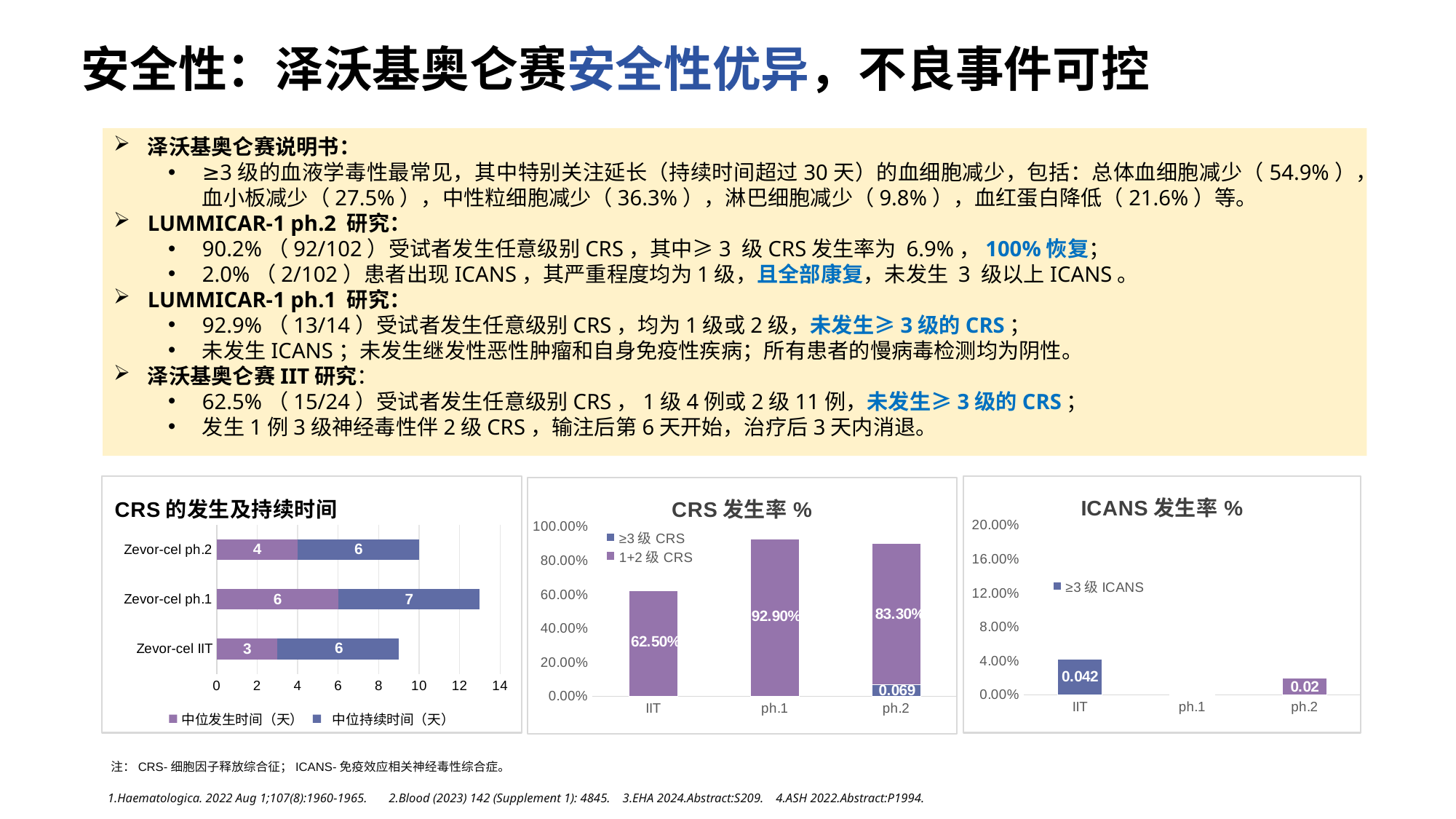
In the chart titled 'CRS 的发生及持续时间', how many series does the legend list? 2 In the chart titled 'CRS 发生率 %', which category has the highest 1+2 级 CRS value? ph.1 In the chart titled 'CRS 的发生及持续时间', what is the total of the stacked bar for Zevor-cel ph.1? 13 In the chart titled 'CRS 发生率 %', what kind of chart is shown? bar chart In the chart titled 'CRS 的发生及持续时间', what is the 中位发生时间（天） value for Zevor-cel ph.1? 6 In the chart titled 'CRS 的发生及持续时间', what is the 中位持续时间（天） value for Zevor-cel ph.2? 6 In the chart titled 'CRS 的发生及持续时间', which category has the lowest 中位发生时间（天） value? Zevor-cel IIT In the chart titled 'ICANS 发生率 %', which of IIT or ph.2 has the larger ≥3 级 ICANS value? IIT In the chart titled 'CRS 发生率 %', what is the difference between the 1+2 级 CRS values for ph.1 and ph.2? 9.60% In the chart titled 'ICANS 发生率 %', what is the data label shown for IIT? 0.042 In the chart titled 'CRS 发生率 %', what is the 1+2 级 CRS value for ph.1? 92.90% In the chart titled 'CRS 发生率 %', what is the 1+2 级 CRS value for IIT? 62.50%